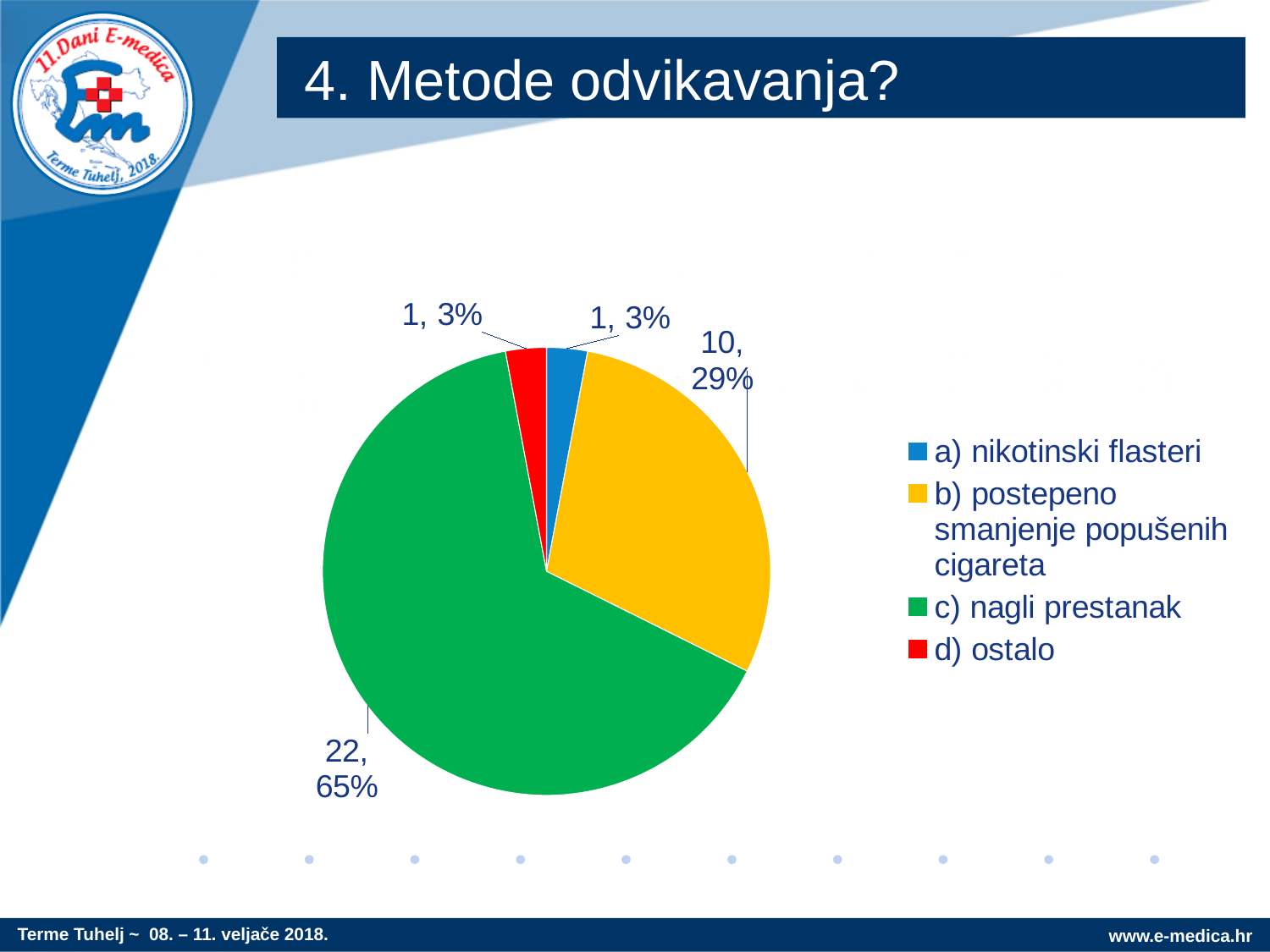
What is the count for 'b) postepeno smanjenje popušenih cigareta'? 10 How many slices does the pie chart have? 4 What is the count for 'c) nagli prestanak'? 22 Which is larger, the slice for 'b) postepeno smanjenje popušenih cigareta' or the slice for 'd) ostalo'? b) postepeno smanjenje popušenih cigareta What share of the pie does 'd) ostalo' represent? 3% What share of the pie does 'b) postepeno smanjenje popušenih cigareta' represent? 29% What is the count for 'a) nikotinski flasteri'? 1 What is the difference in count between 'c) nagli prestanak' and 'b) postepeno smanjenje popušenih cigareta'? 12 Which category has the largest slice? c) nagli prestanak What colour is the slice for 'd) ostalo'? red What kind of chart is shown on the slide? pie chart What share of the pie does 'c) nagli prestanak' represent? 65%